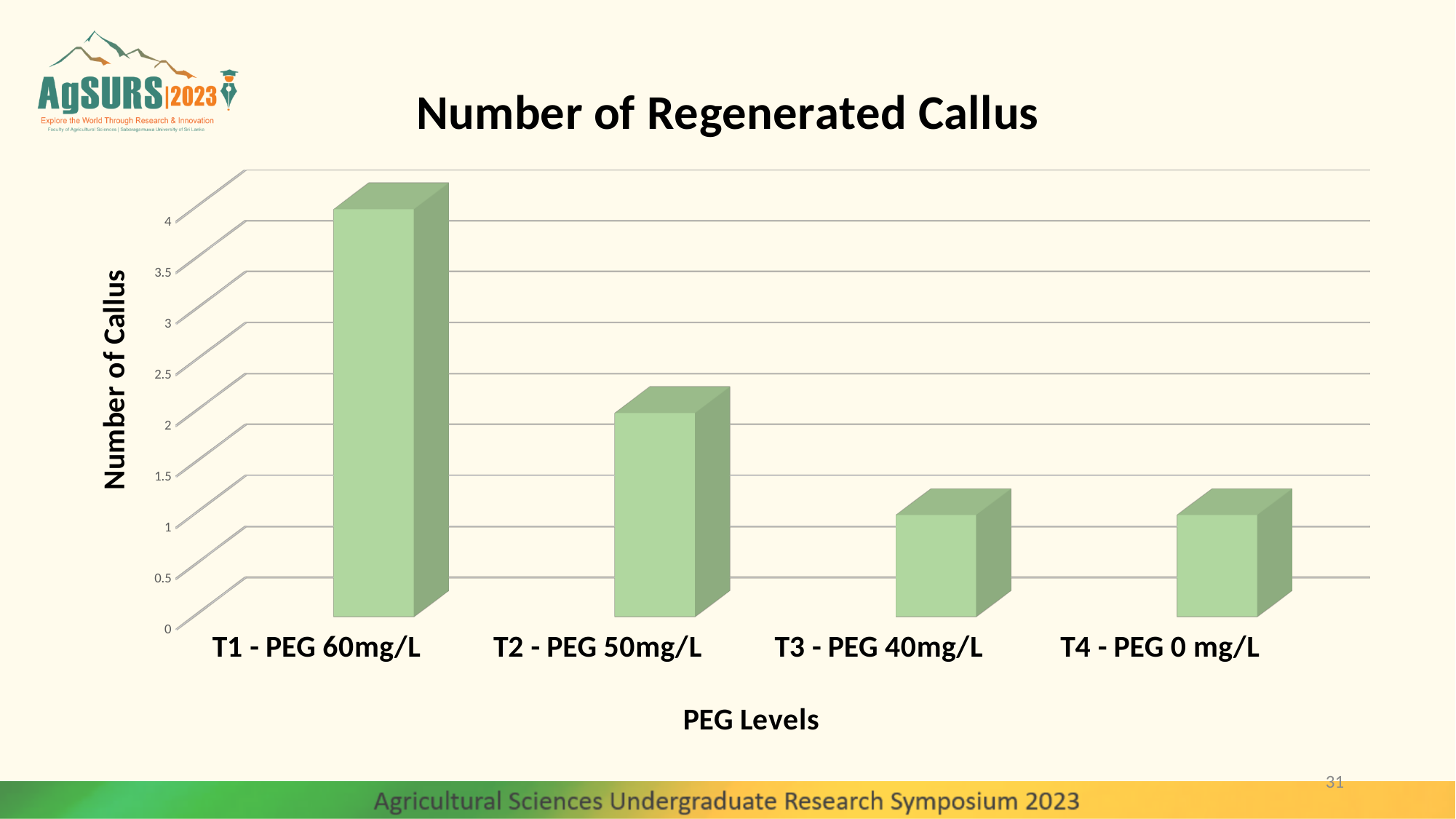
How many PEG level categories are plotted on the x axis? 4 Is the value for T4 - PEG 0 mg/L greater or less than 2? less Which has a higher number of callus, T1 - PEG 60mg/L or T2 - PEG 50mg/L? T1 - PEG 60mg/L Which PEG level has the highest number of regenerated callus? T1 - PEG 60mg/L What kind of chart is shown on the slide? Bar chart Is the value for T3 - PEG 40mg/L greater or less than 2? less What is the label of the y axis? Number of Callus Is the value for T1 - PEG 60mg/L greater or less than 3? greater What is the title of the chart? Number of Regenerated Callus Do the values generally rise or fall moving from T1 to T4 along the x axis? fall